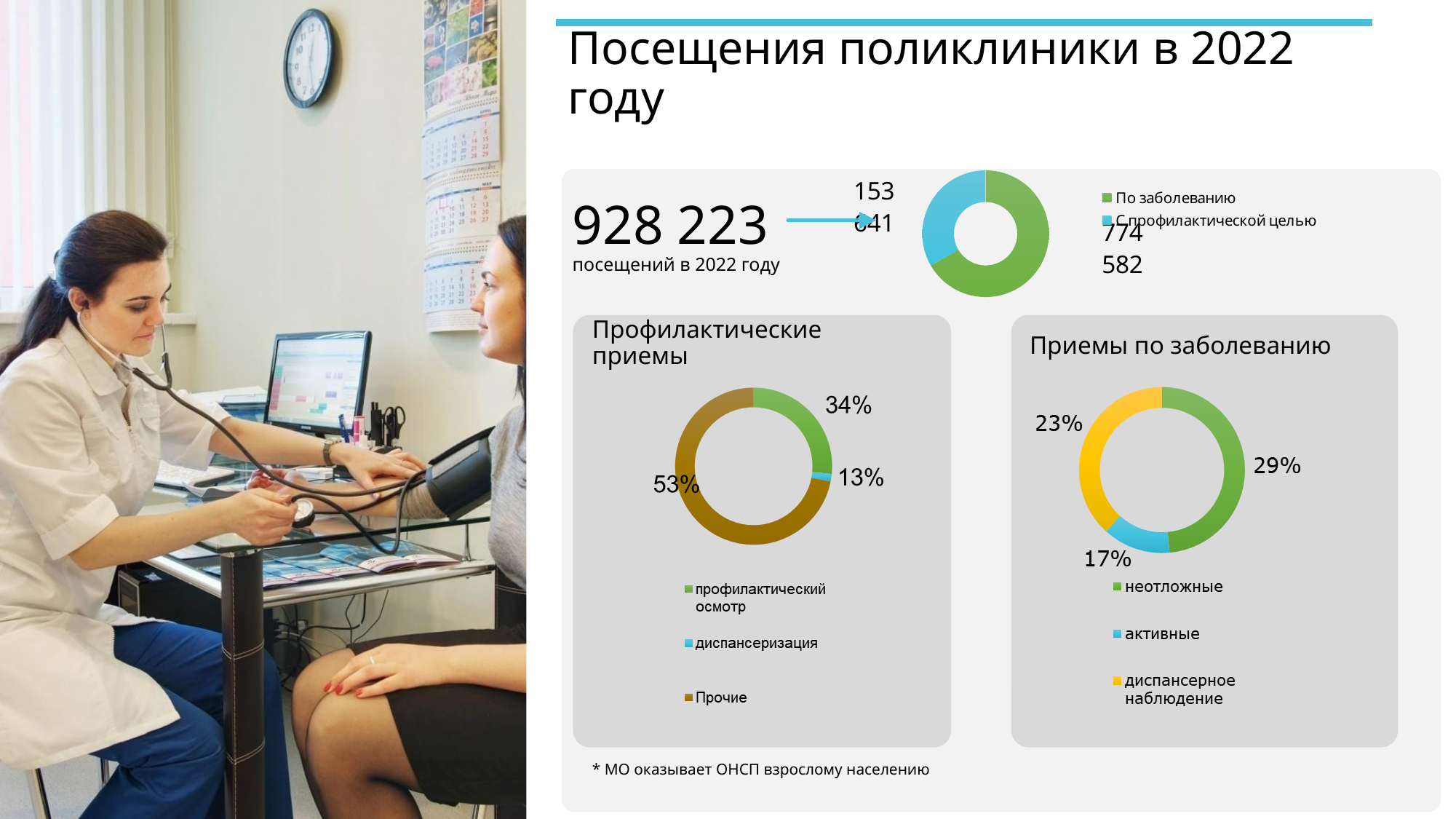
On the chart titled 'Профилактические приемы', what percentage is shown for 'Прочие'? 53% On the chart titled 'Профилактические приемы', which category has the largest share? Прочие On the chart titled 'Приемы по заболеванию', what percentage is shown for 'диспансерное наблюдение'? 23% On the chart titled 'Приемы по заболеванию', what percentage is shown for 'неотложные'? 29% On the chart titled 'Профилактические приемы', what percentage is shown for 'профилактический осмотр'? 34% On the chart titled 'Приемы по заболеванию', which category has the smallest share? активные On the chart titled 'Приемы по заболеванию', what percentage is shown for 'активные'? 17% On the chart titled 'Профилактические приемы', which category has the smallest share? диспансеризация On the top donut chart next to '928 223', which category is larger: 'По заболеванию' or 'С профилактической целью'? По заболеванию On the chart titled 'Приемы по заболеванию', how many categories does the legend list? 3 On the chart titled 'Профилактические приемы', what is the difference between the shares of 'Прочие' and 'профилактический осмотр'? 19% On the chart titled 'Профилактические приемы', what percentage is shown for 'диспансеризация'? 13%